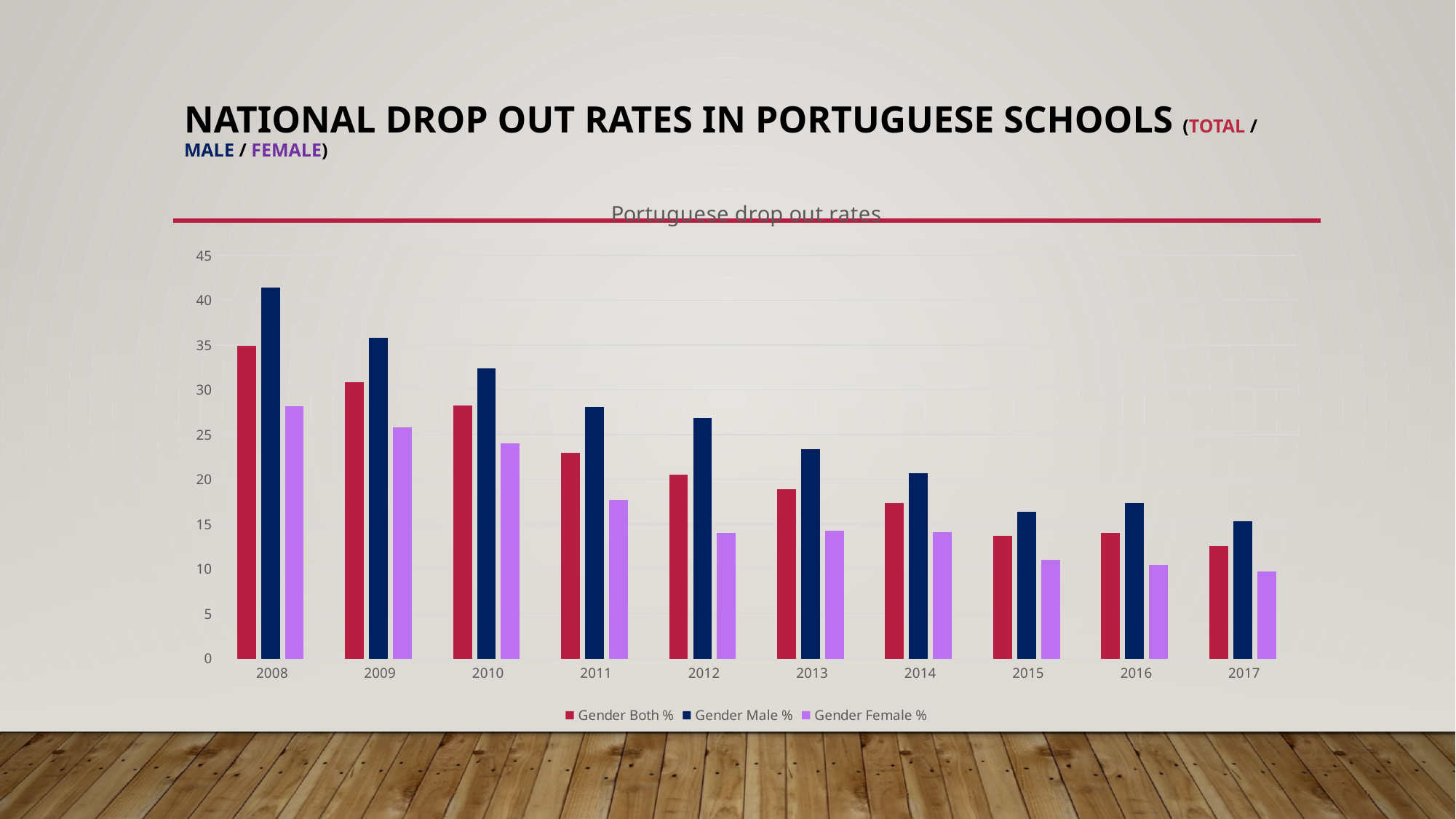
How many years are shown on the x axis? 10 In which year is the Gender Male % value highest? 2008 In 2012, which is larger: Gender Male % or Gender Female %? Gender Male % In which year is the Gender Female % value lowest? 2017 Is the Gender Both % value for 2011 greater or less than 25? less Do the Gender Both % values generally rise or fall from 2008 to 2017? fall How many series does the legend list? 3 Is the Gender Male % value for 2008 greater or less than 40? greater What is the title of the chart? Portuguese drop out rates Is the Gender Female % value for 2008 greater or less than 25? greater What kind of chart is shown on the slide? bar chart